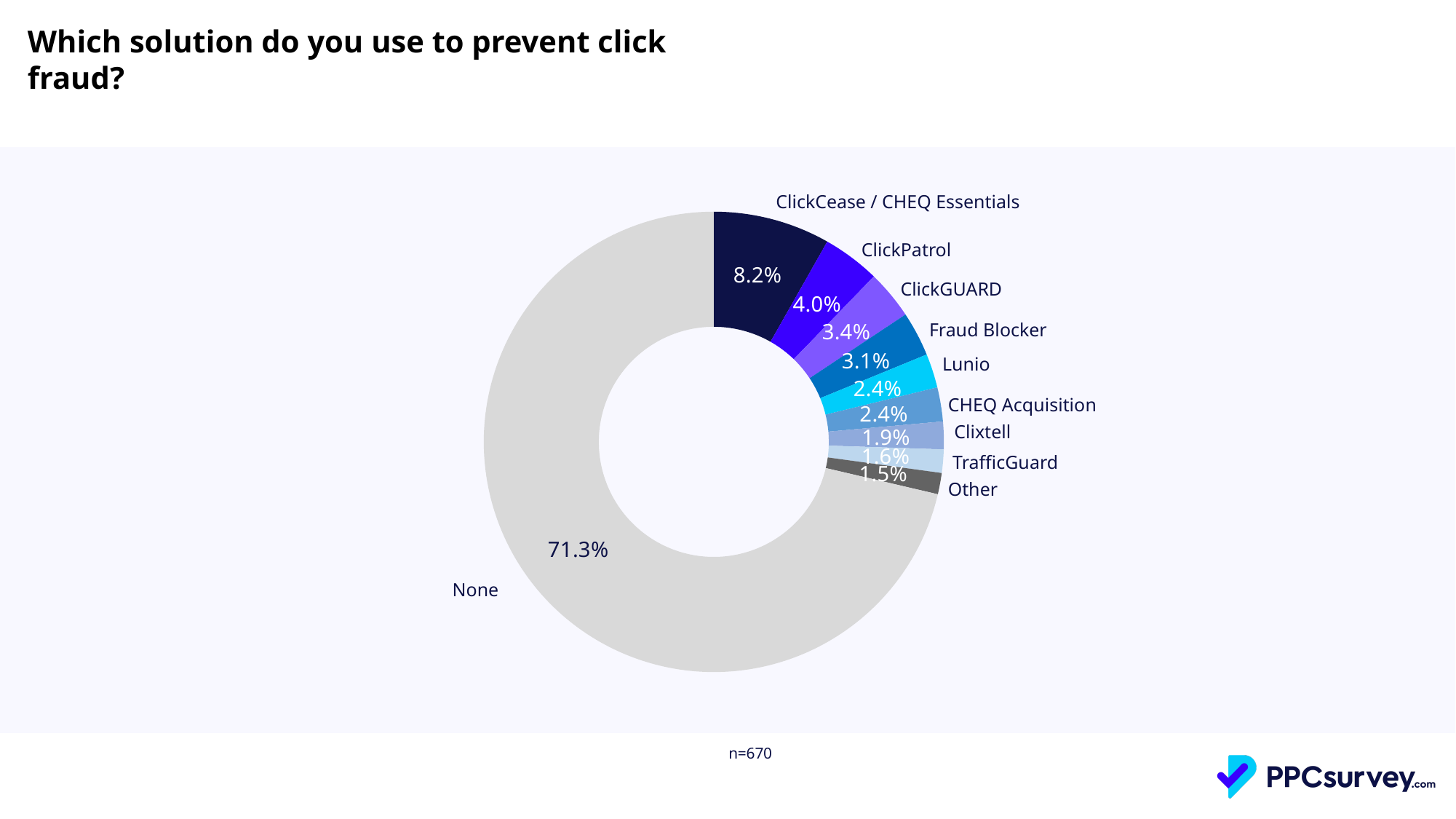
What kind of chart is shown on the slide? doughnut chart What is the value for Fraud Blocker? 3.1% What is the sample size noted below the chart? n=670 What is the difference between the shares for ClickCease / CHEQ Essentials and ClickPatrol? 4.2% What percentage of respondents selected None? 71.3% What is the value for Clixtell? 1.9% Which is larger, the share for ClickGUARD or the share for Lunio? ClickGUARD What share of respondents use ClickCease / CHEQ Essentials? 8.2% Which category has the largest share of the pie? None How many categories are shown in the pie chart? 10 What is the value for ClickPatrol? 4.0% Which category has the smallest share of the pie? Other